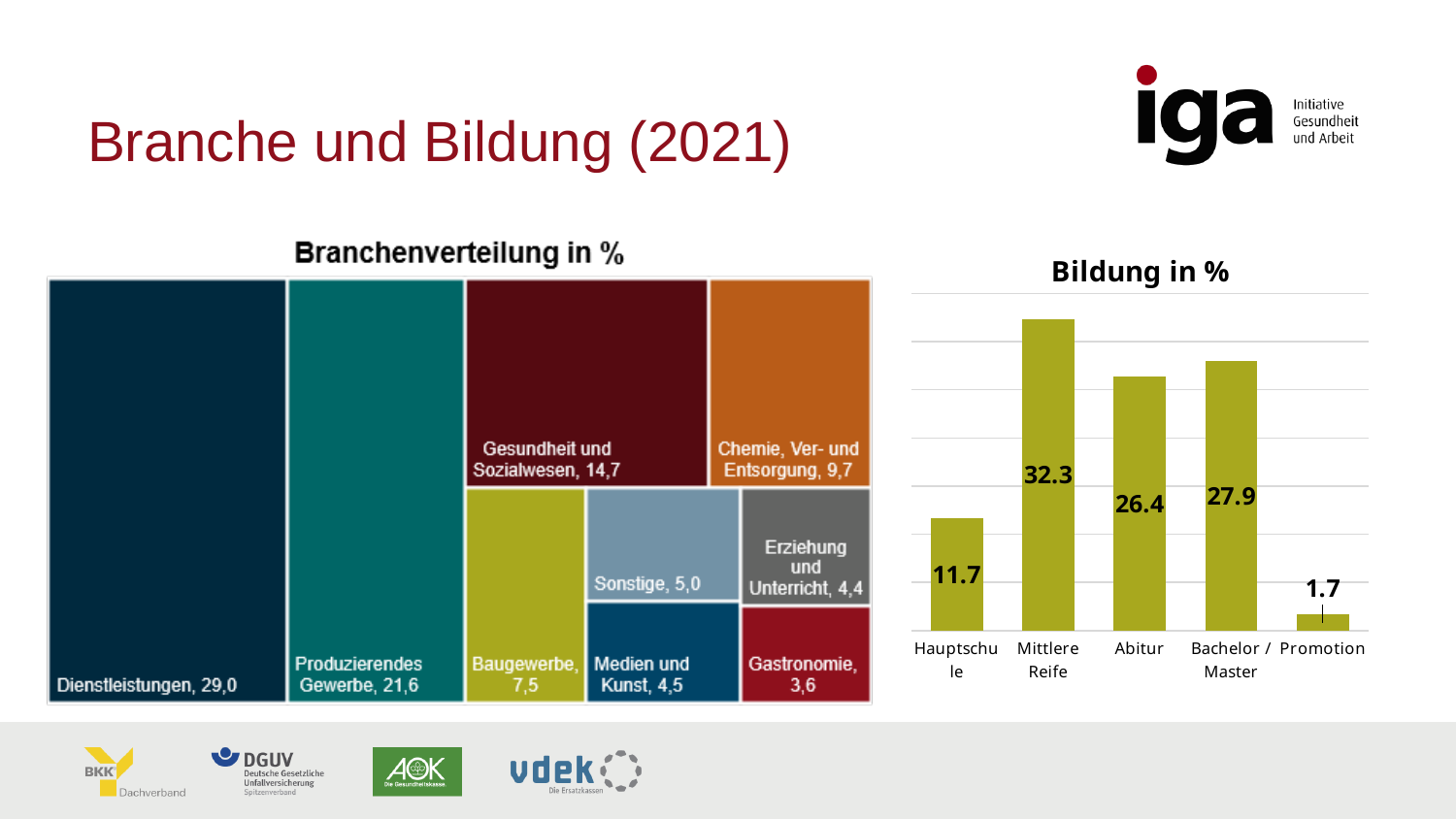
What kind of chart is the 'Bildung in %' chart? bar chart In the 'Branchenverteilung in %' chart, what is the difference between Dienstleistungen and Produzierendes Gewerbe? 7,4 In the 'Bildung in %' chart, which is larger: Hauptschule or Abitur? Abitur In the 'Branchenverteilung in %' chart, which sector has the largest share? Dienstleistungen In the 'Bildung in %' chart, what is the value for Mittlere Reife? 32.3 In the 'Branchenverteilung in %' chart, which is larger: Baugewerbe or Sonstige? Baugewerbe In the 'Bildung in %' chart, what is the difference between Bachelor / Master and Abitur? 1.5 In the 'Bildung in %' chart, what is the value for Promotion? 1.7 In the 'Branchenverteilung in %' chart, what is the value for Gesundheit und Sozialwesen? 14,7 In the 'Bildung in %' chart, which category has the highest value? Mittlere Reife In the 'Bildung in %' chart, which category has the lowest value? Promotion How many categories are shown in the 'Bildung in %' chart? 5